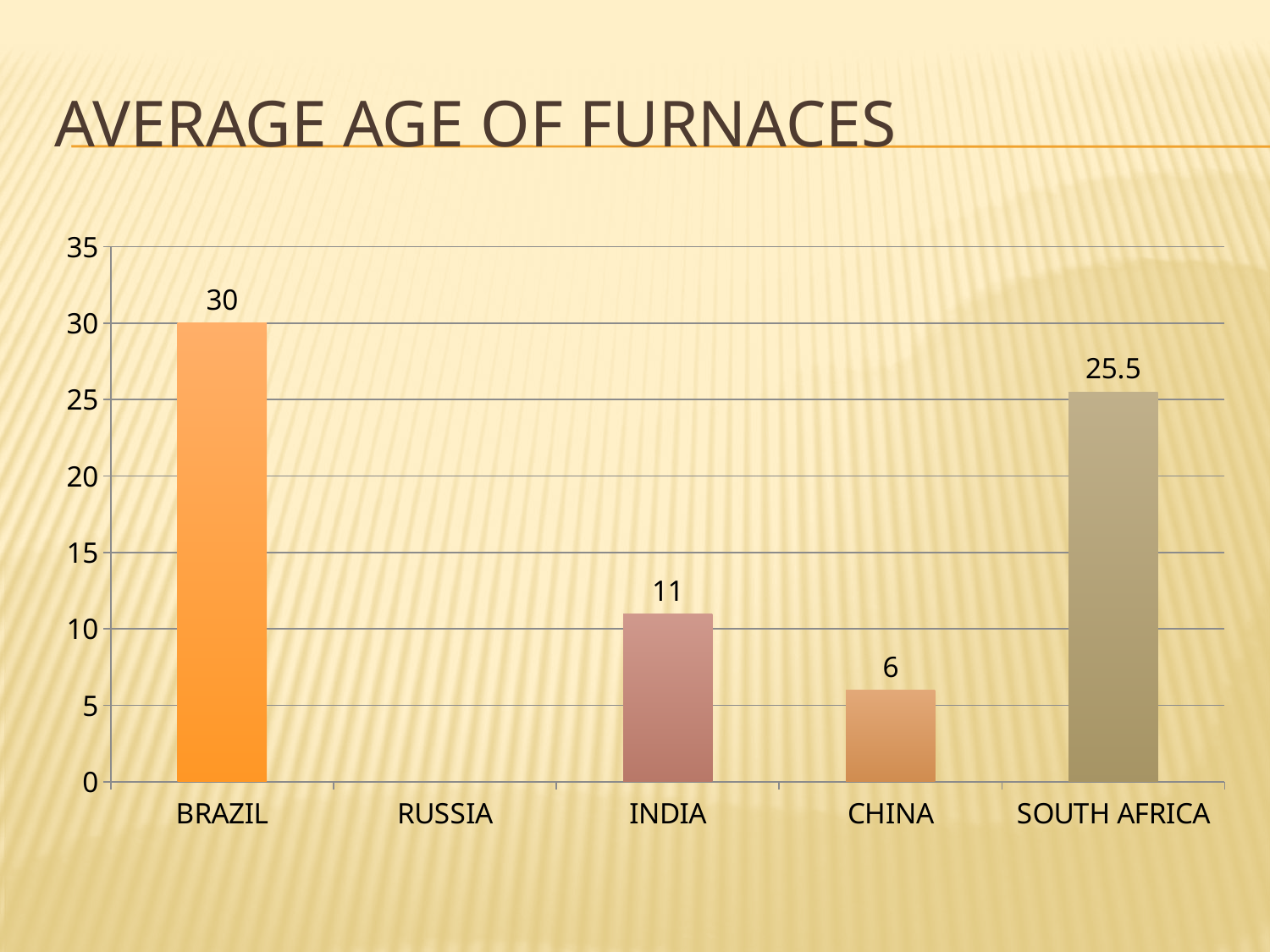
What is the value shown for BRAZIL? 30 Which has the larger value, SOUTH AFRICA or BRAZIL? BRAZIL What is the title of the slide? AVERAGE AGE OF FURNACES What is the value shown for SOUTH AFRICA? 25.5 How many countries are labelled on the x axis? 5 What is the difference between the values for INDIA and CHINA? 5 What is the value shown for CHINA? 6 Which country has the highest bar? BRAZIL What is the value shown for INDIA? 11 What is the difference between the values for BRAZIL and SOUTH AFRICA? 4.5 What kind of chart is shown on the slide? bar chart Which has the larger value, INDIA or CHINA? INDIA